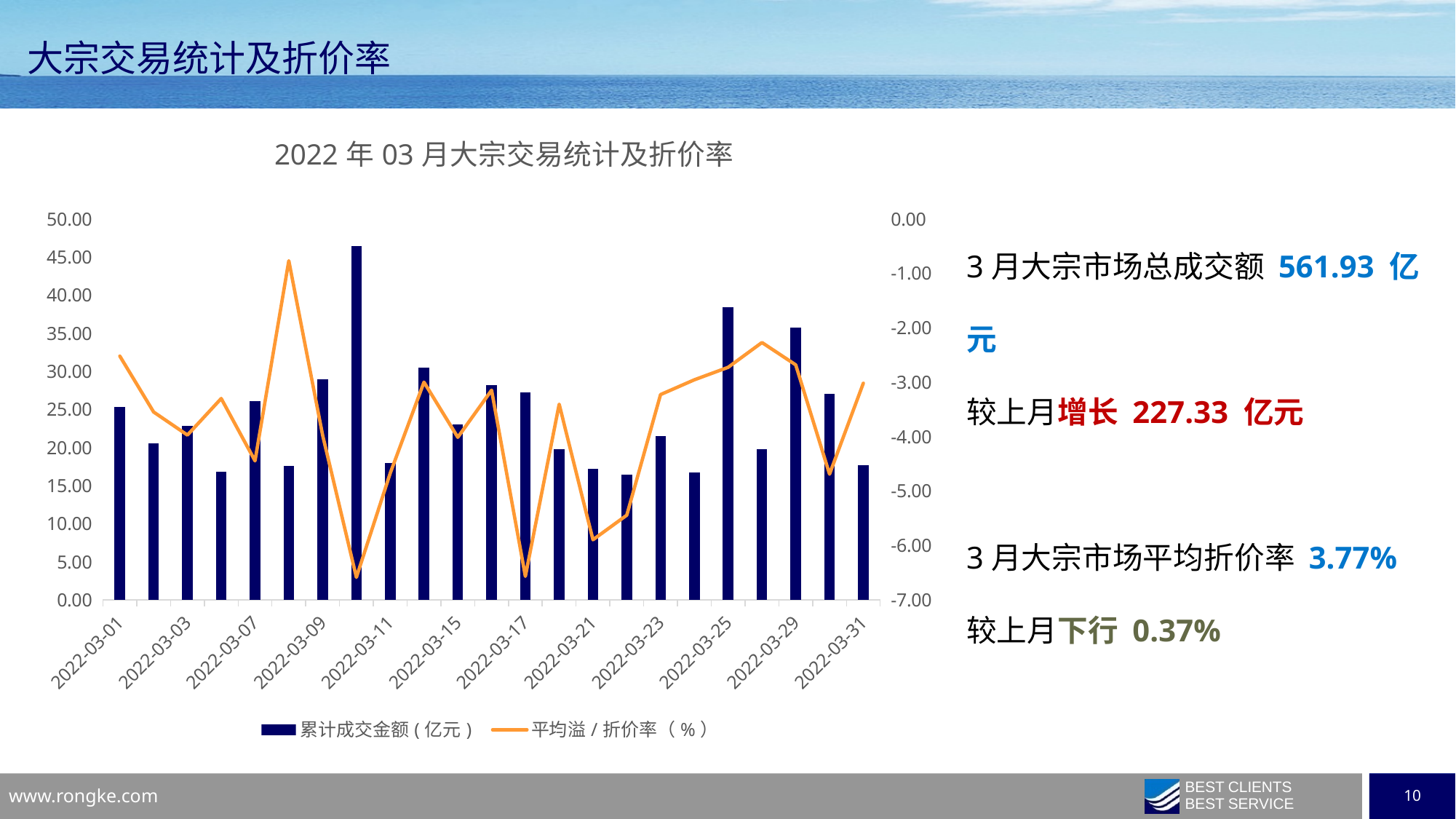
Is the 累计成交金额 bar for 2022-03-25 greater or less than 35.00? greater What is the title of the chart? 2022 年 03 月大宗交易统计及折价率 How many bars (trading days) are plotted in the chart? 23 How many series does the chart legend list? 2 On the right axis, is the 平均溢/折价率 line value for 2022-03-17 greater or less than -6.00? less Which has the larger 累计成交金额 bar, 2022-03-25 or 2022-03-31? 2022-03-25 Is the 累计成交金额 bar for 2022-03-01 greater or less than 20.00? greater Which series is drawn as bars according to the legend? 累计成交金额(亿元) What kind of chart is shown on the slide? A combined bar and line chart